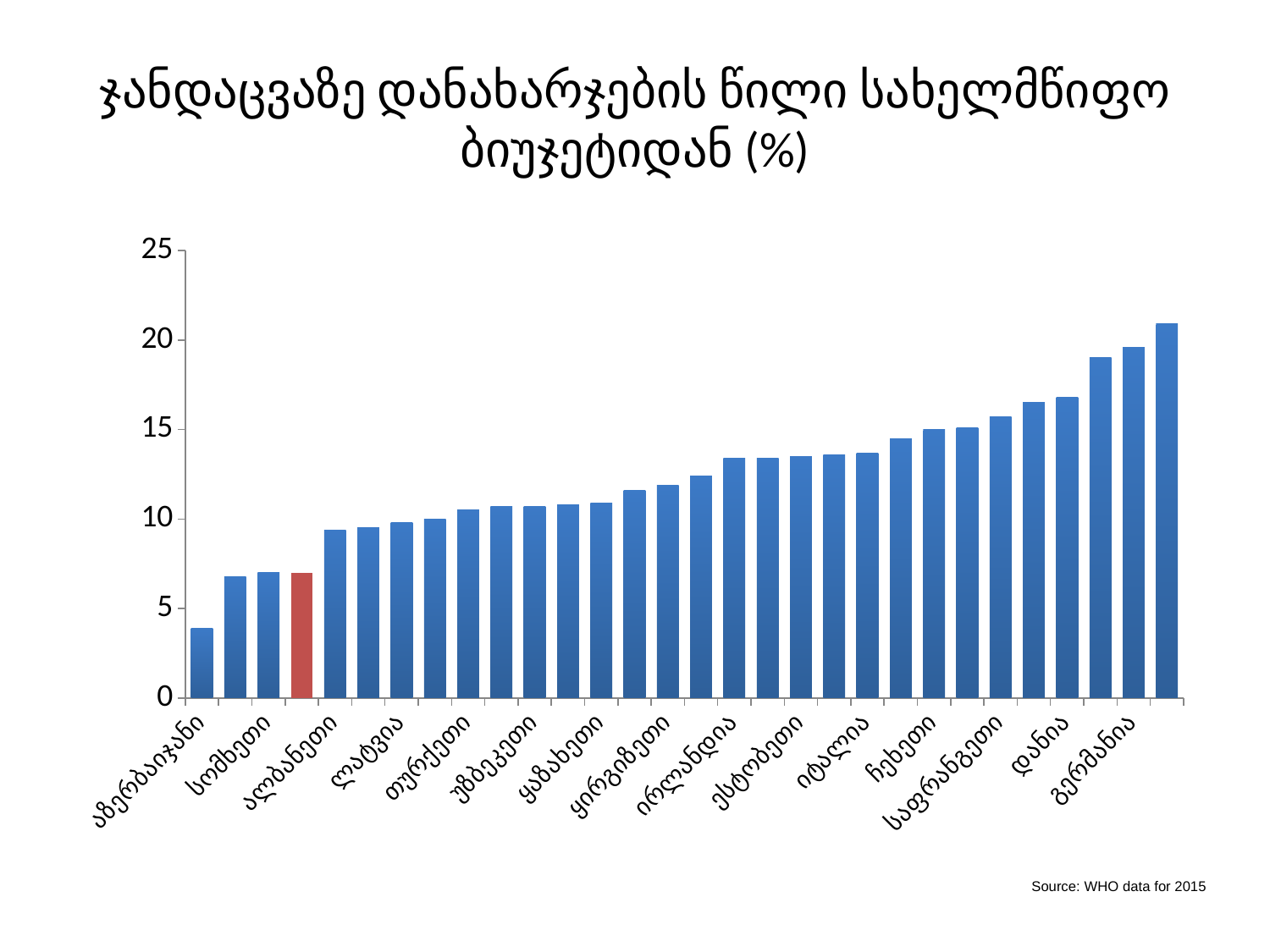
Is the value for საფრანგეთი greater or less than 20? less Is the value for ყირგიზეთი greater or less than 10? greater Is the value for ირლანდია greater or less than 15? less What colour is the single highlighted bar that differs from the others? red How many bars are plotted in the chart? 30 Which has the larger value, სომხეთი or ჩეხეთი? ჩეხეთი Do the bar values rise or fall from left to right along the x axis? rise What kind of chart is shown on the slide? bar chart Which country has the lowest value in the chart? აზერბაიჯანი